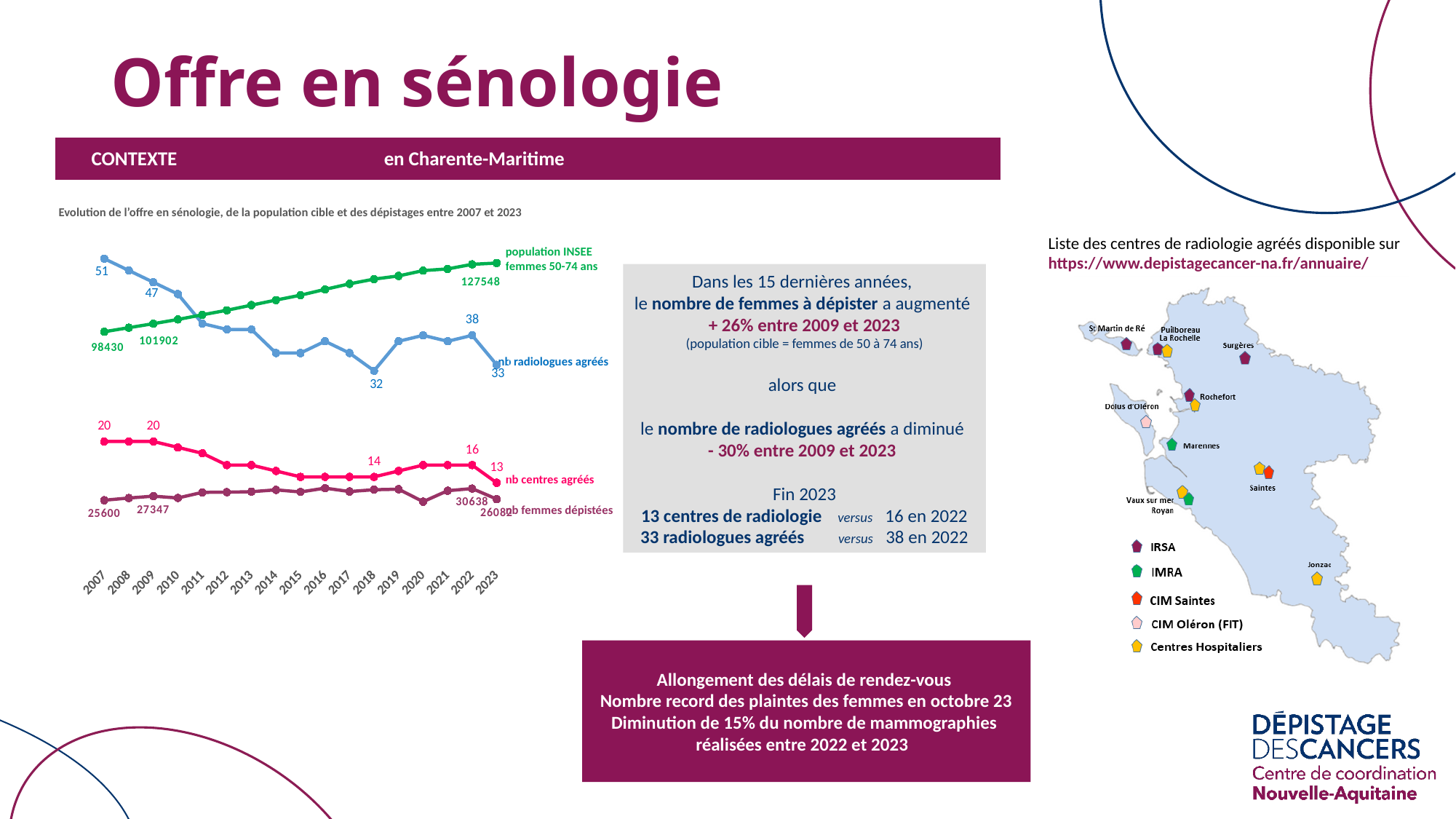
What was the number of radiologues agréés in 2007? 51 Which is larger: the number of centres agréés in 2009 or in 2023? 2009 Does the population INSEE femmes 50-74 ans rise or fall from 2007 to 2023? rise What was the number of femmes dépistées in 2022? 30638 By how much did the number of radiologues agréés fall between 2022 and 2023? 5 Which series is drawn in green on the chart? population INSEE femmes 50-74 ans What was the number of radiologues agréés in 2018? 32 What kind of chart is shown on the left of the slide? line chart How many years are plotted along the x axis of the chart? 17 What was the number of centres agréés in 2023? 13